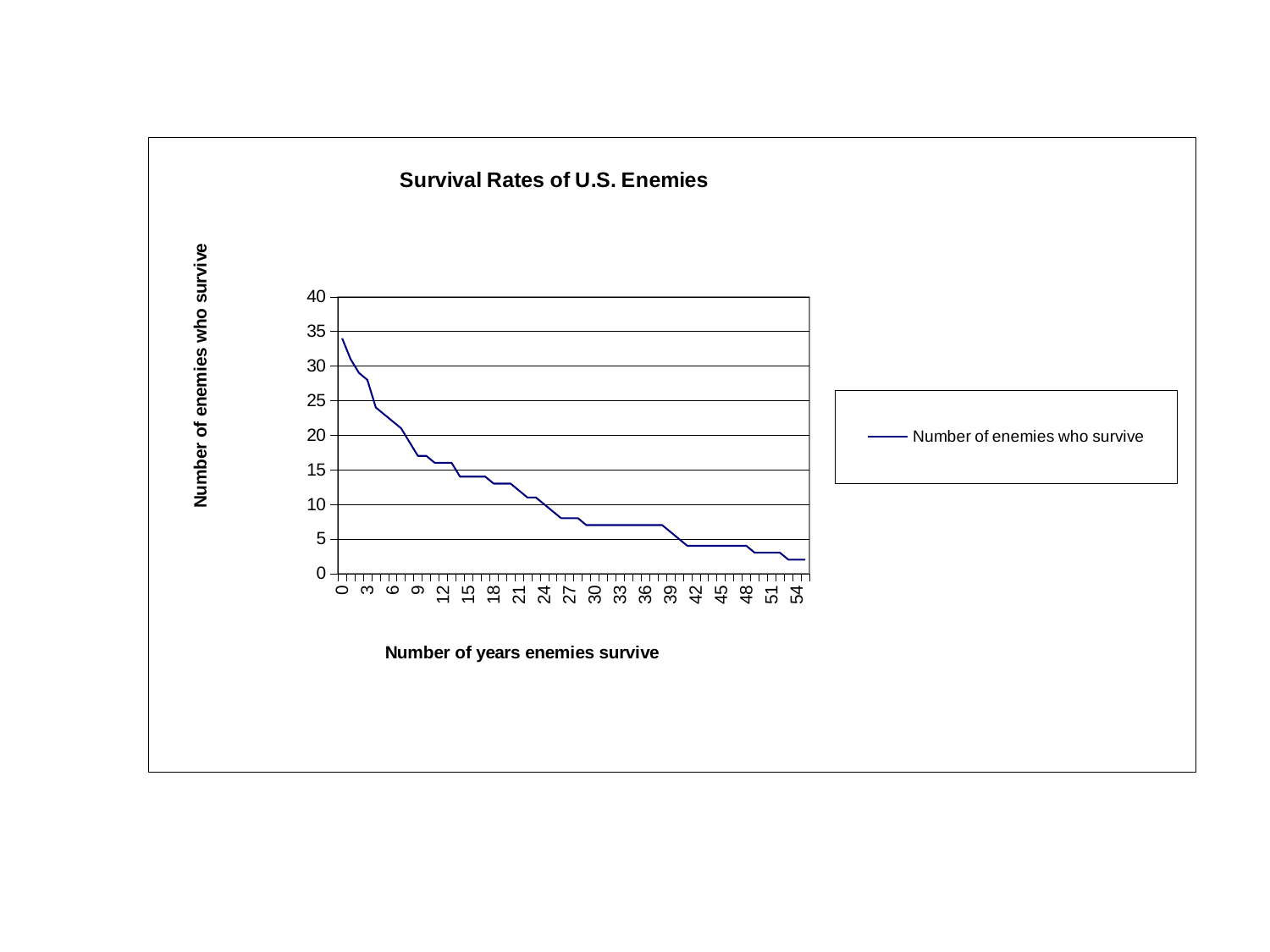
Is the number of enemies who survive at 6 years greater or less than 20? greater Is the number of enemies who survive at 54 years greater or less than 5? less Is the number of enemies who survive at 30 years greater or less than 10? less Do the values rise or fall as the number of years increases along the x axis? fall What is the label of the x axis? Number of years enemies survive What is the title of the chart? Survival Rates of U.S. Enemies How many series does the legend list? 1 What kind of chart is shown on the slide? line chart